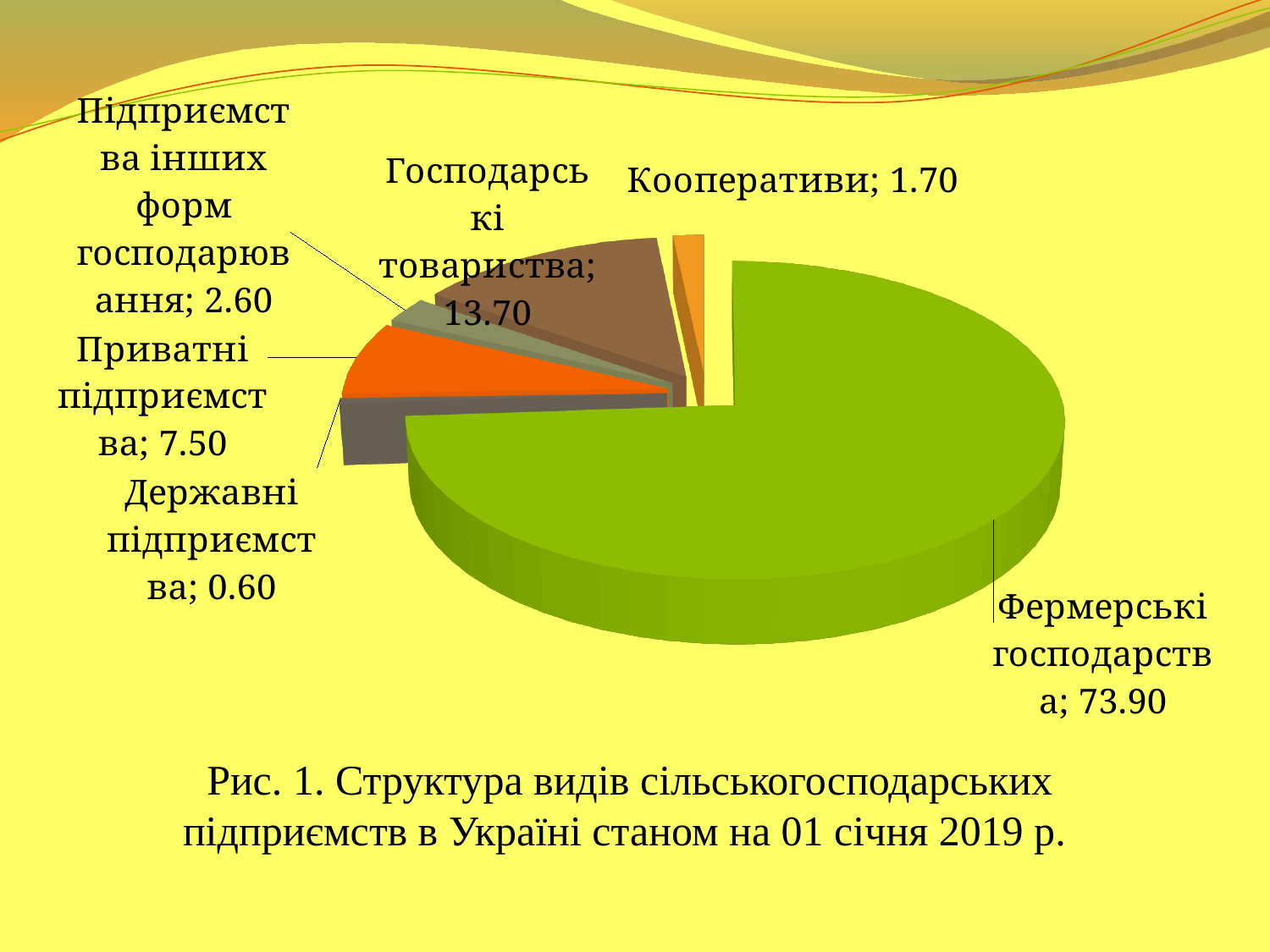
What is the value for Фермерські господарства? 73.90 What is the difference between the values for Господарські товариства and Приватні підприємства? 6.20 What kind of chart is shown on the slide? pie chart What is the value for Державні підприємства? 0.60 Which is larger: the value for Підприємства інших форм господарювання or the value for Кооперативи? Підприємства інших форм господарювання What is the value for Господарські товариства? 13.70 Which category has the largest slice of the pie? Фермерські господарства What is the caption (title) given below the chart? Рис. 1. Структура видів сільськогосподарських підприємств в Україні станом на 01 січня 2019 р. How many categories (slices) does the pie chart have? 6 What is the value for Приватні підприємства? 7.50 What is the value for Кооперативи? 1.70 Which category has the smallest slice of the pie? Державні підприємства